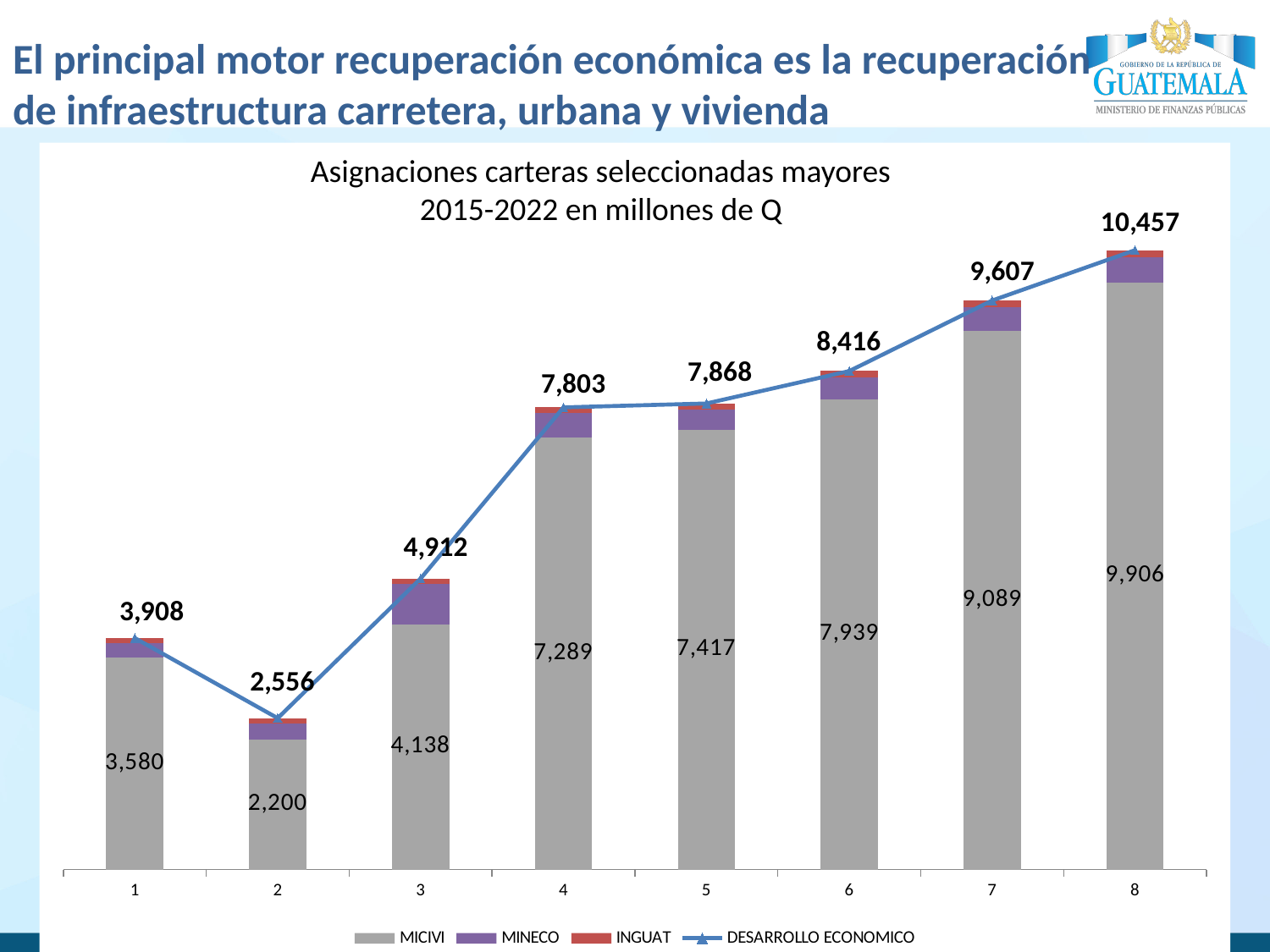
What kind of chart is shown on the slide? Stacked bar chart with a line What is the difference between the MICIVI values for category 5 and category 4? 128 Which category has the lowest MICIVI value? 2 Which is larger, the MICIVI value for category 1 or for category 3? category 3 How many categories are shown on the x axis? 8 Which category has the highest DESARROLLO ECONOMICO value? 8 What is the MICIVI value for category 8? 9,906 What is the difference between the DESARROLLO ECONOMICO values for category 8 and category 7? 850 What is the MICIVI value for category 2? 2,200 Does the DESARROLLO ECONOMICO line rise or fall from category 3 to category 8? rise What is the DESARROLLO ECONOMICO value for category 3? 4,912 How many series does the legend list? 4